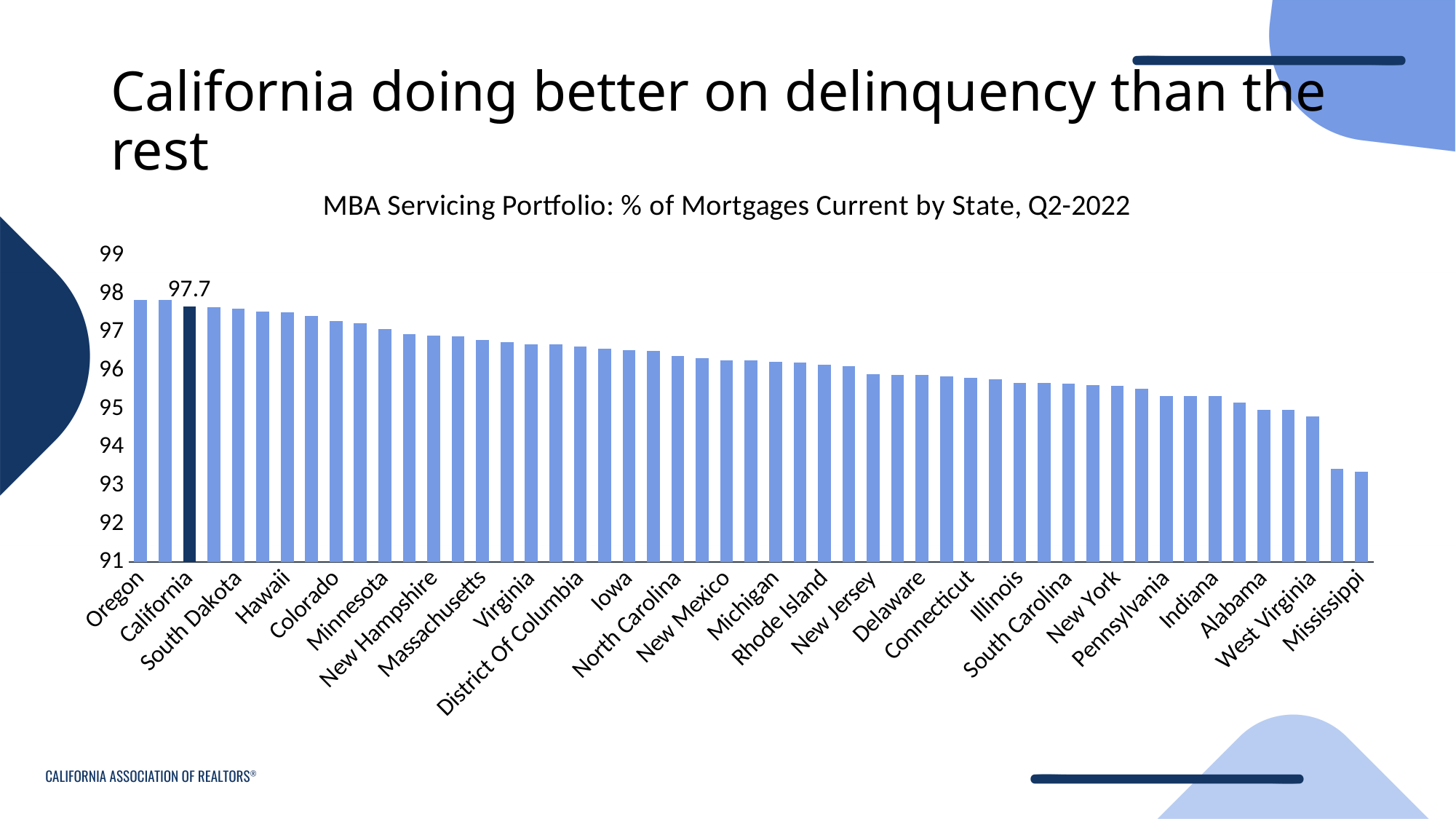
What kind of chart is shown on the slide? bar chart Do the values rise or fall moving from left to right along the x axis? fall Which has a higher value, California or New York? California What is the title of the chart? MBA Servicing Portfolio: % of Mortgages Current by State, Q2-2022 Is the value for Mississippi greater or less than 94? less Which state's bar is highlighted in a dark colour? California What is the value shown for California? 97.7 Which has a higher value, Oregon or Mississippi? Oregon Is the value for New York greater or less than 95? greater Is the value for Iowa greater or less than 96? greater